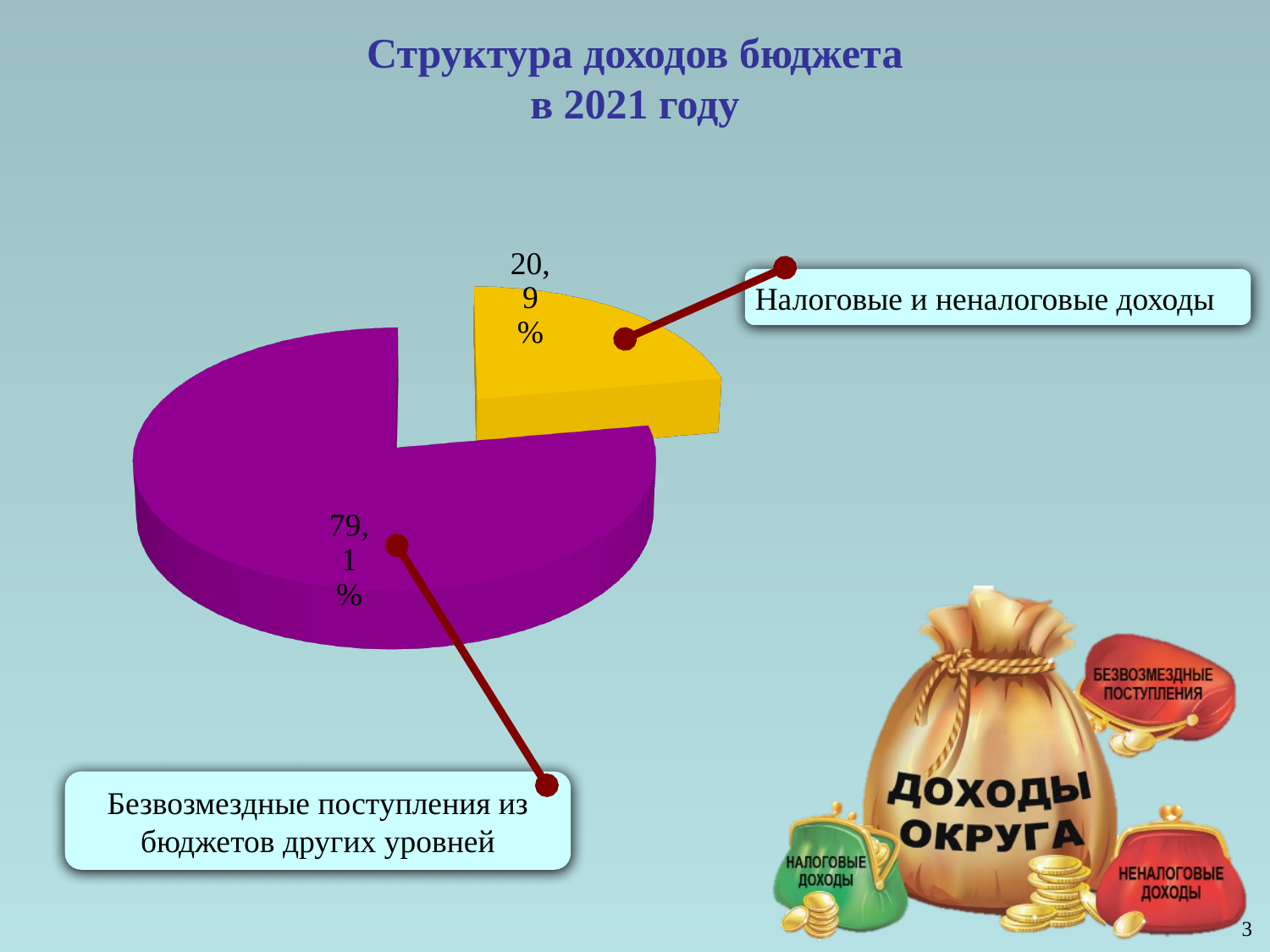
What type of chart is shown on the slide? pie chart Is the share for "Налоговые и неналоговые доходы" greater or less than 25%? less What is the title of the chart on the slide? Структура доходов бюджета в 2021 году Which slice of the pie chart is the largest? Безвозмездные поступления из бюджетов других уровней What colour is the slice representing "Налоговые и неналоговые доходы"? yellow What is the difference in percentage points between the "Безвозмездные поступления из бюджетов других уровней" slice and the "Налоговые и неналоговые доходы" slice? 58,2 Is the share for "Безвозмездные поступления из бюджетов других уровней" greater or less than 75%? greater How many slices does the pie chart have? 2 What share of the pie is labelled "Безвозмездные поступления из бюджетов других уровней"? 79,1% Which is larger: the share for "Налоговые и неналоговые доходы" or the share for "Безвозмездные поступления из бюджетов других уровней"? Безвозмездные поступления из бюджетов других уровней What share of the pie is labelled "Налоговые и неналоговые доходы"? 20,9% Which slice of the pie chart is the smallest? Налоговые и неналоговые доходы